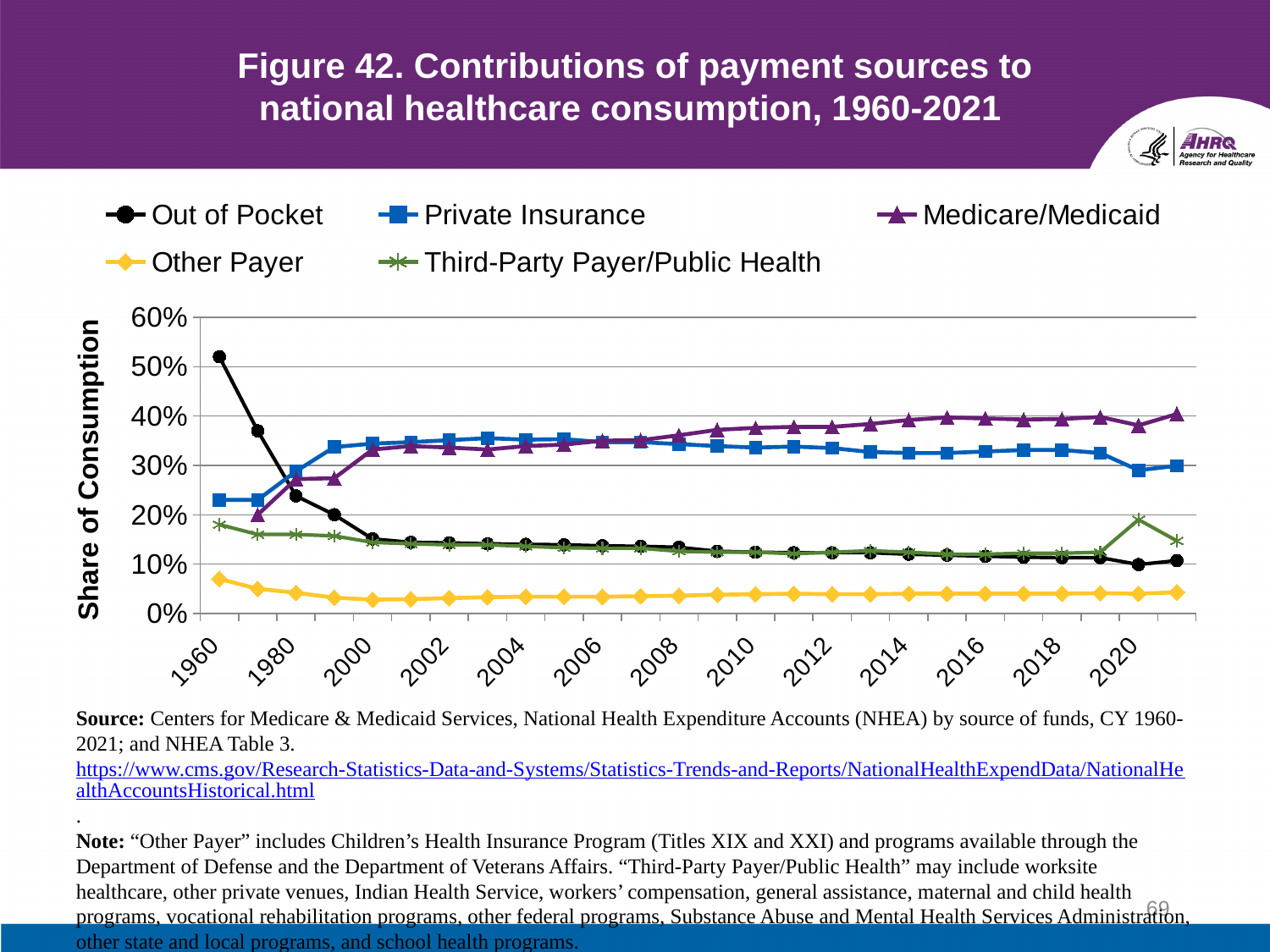
Is the Other Payer share in 1960 greater or less than 10%? less Which payment source has the highest share of consumption in 1960? Out of Pocket Is the Medicare/Medicaid share in 2020 greater or less than 30%? greater What is the label on the vertical axis of the chart? Share of Consumption What kind of chart is shown on the slide? line chart How many series does the legend list? 5 Which payment source has the lowest share of consumption in 2020? Other Payer Does the Medicare/Medicaid share rise or fall from 1960 to 2020? rise Is the Out of Pocket share in 1960 greater or less than 50%? greater Which payment source has the highest share of consumption in 2020? Medicare/Medicaid Which payment source has the lowest share of consumption in 1960? Other Payer Does the Out of Pocket share rise or fall from 1960 to 2020? fall